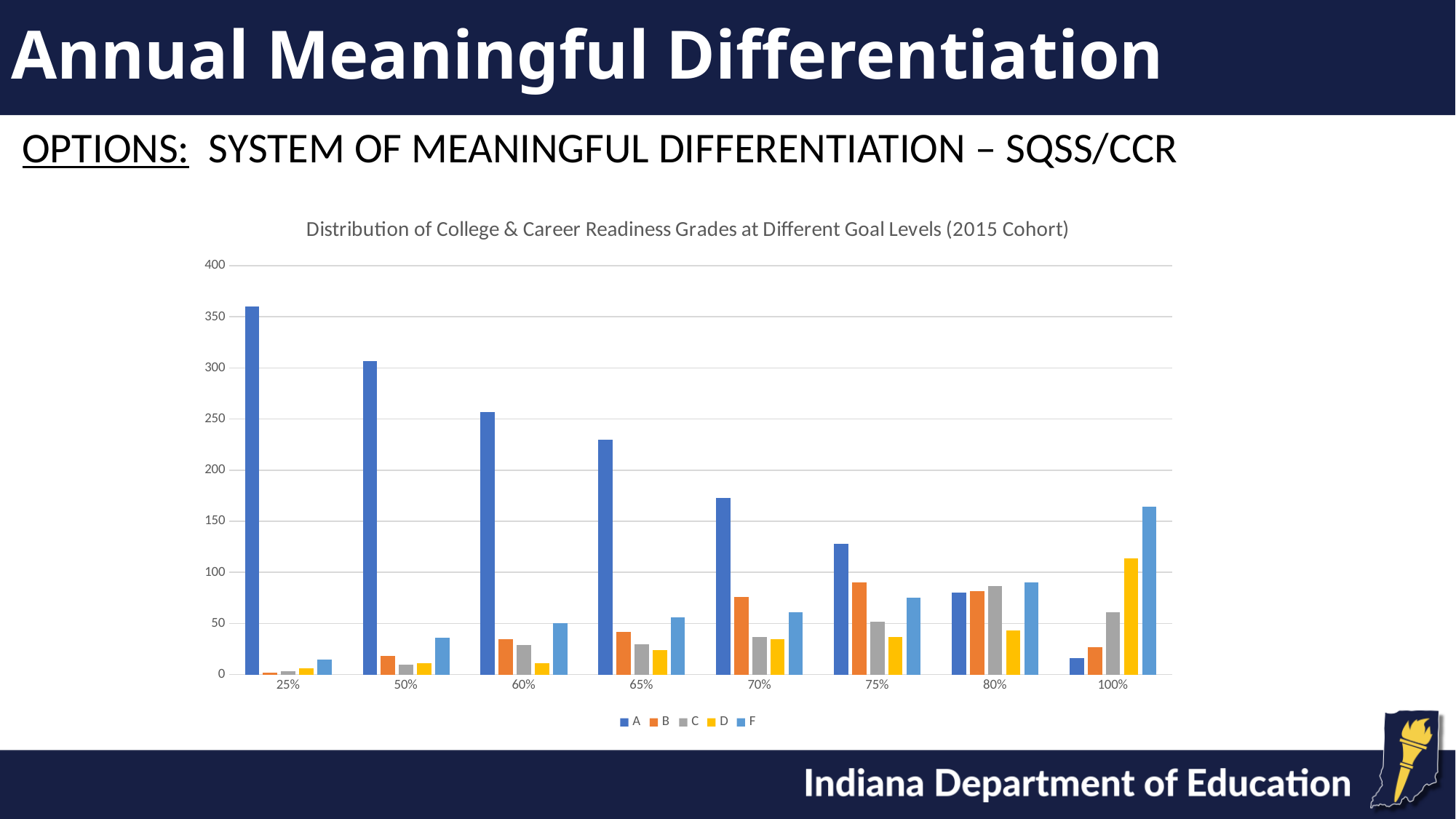
Is the value for series F at 100% greater or less than 150? greater Is the value for series A at 25% greater or less than 300? greater At the 100% goal level, which is larger, series D or series F? F What kind of chart is shown on the slide? bar chart Does the value for series F rise or fall as the goal level increases along the x axis? rise How many series does the legend list? 5 Is the value for series A at 65% greater or less than 250? less Which goal level has the highest bar for series A? 25% At the 75% goal level, which is larger, series A or series B? A What is the title of the chart? Distribution of College & Career Readiness Grades at Different Goal Levels (2015 Cohort) How many goal-level categories are shown on the x axis? 8 Does the value for series A rise or fall as the goal level increases along the x axis? fall